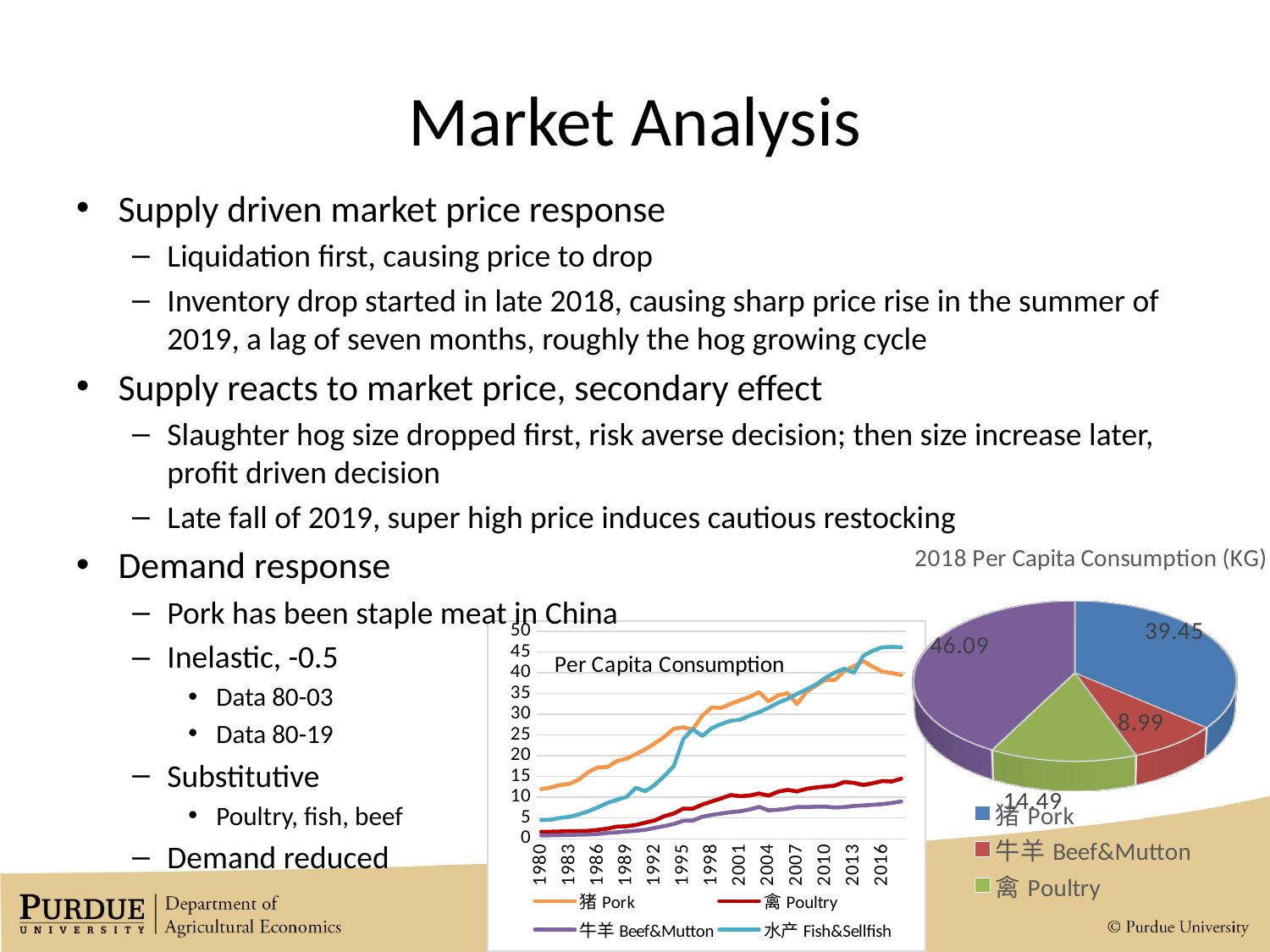
In the 'Per Capita Consumption' line chart, which is larger in 2016, Pork or Beef&Mutton? Pork What type of chart is the '2018 Per Capita Consumption (KG)' chart on the right? pie chart In the '2018 Per Capita Consumption (KG)' pie chart, which is larger, Poultry or Beef&Mutton? Poultry In the 'Per Capita Consumption' line chart, is the Pork value in 1980 greater or less than 15? less In the 'Per Capita Consumption' line chart, is the Fish&Shellfish value in 2016 greater or less than 40? greater In the '2018 Per Capita Consumption (KG)' pie chart, what is the value for Pork? 39.45 In the '2018 Per Capita Consumption (KG)' pie chart, what is the value for Beef&Mutton? 8.99 In the '2018 Per Capita Consumption (KG)' pie chart, what is the difference between the Pork value and the Poultry value? 24.96 How many series does the legend of the 'Per Capita Consumption' line chart list? 4 What type of chart is the 'Per Capita Consumption' chart on the left? line chart In the 'Per Capita Consumption' line chart, does the Pork series generally rise or fall from 1980 to 2016? rise In the 'Per Capita Consumption' line chart, which series has the lowest value in 2016? Beef&Mutton